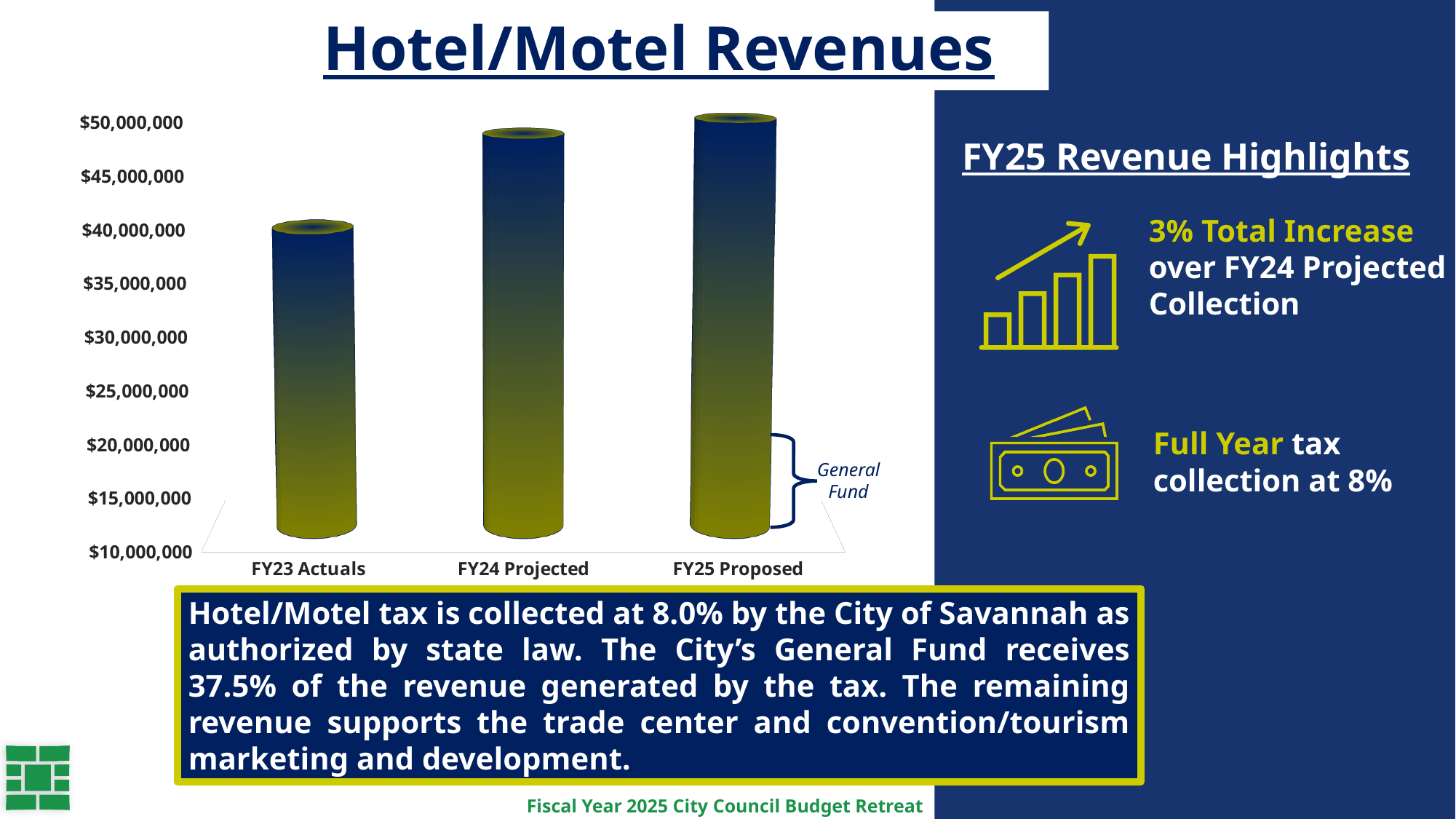
Is the value for FY25 Proposed greater or less than $45,000,000? greater How many categories are plotted on the x axis of the chart? 3 Which category has the highest value in the chart? FY25 Proposed What is the title of the chart? Hotel/Motel Revenues What label is attached by a bracket to the lower portion of the FY25 Proposed bar? General Fund Is the value for FY24 Projected greater or less than $45,000,000? greater Is the value for FY23 Actuals greater or less than $35,000,000? greater Which category has the lowest value in the chart? FY23 Actuals Which is larger, the value for FY23 Actuals or the value for FY24 Projected? FY24 Projected Do the values rise or fall from FY23 Actuals to FY25 Proposed? Rise What type of chart is shown on the slide? Bar chart